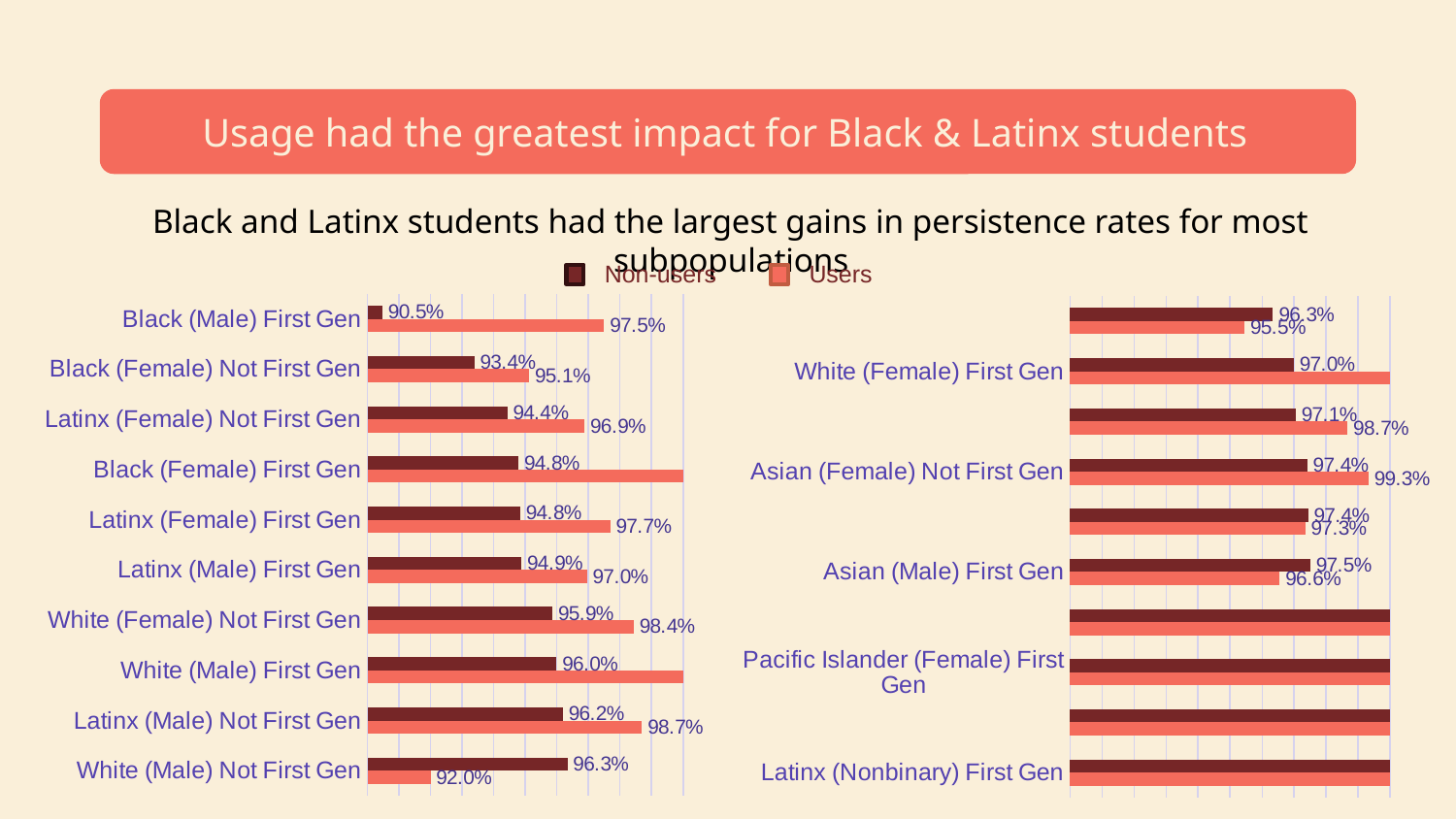
On the left chart, for White (Male) Not First Gen, which is larger: the Non-users rate or the Users rate? Non-users On the left chart, what is the difference between the Users and Non-users rates for Black (Male) First Gen? 7.0 percentage points On the right chart, what is the Users persistence rate for Asian (Female) Not First Gen? 99.3% How many series does the legend list? 2 What type of chart is shown on the left side of the slide? Bar chart On the left chart, which group has the lowest Non-users persistence rate? Black (Male) First Gen On the left chart, what is the Users value for White (Female) Not First Gen? 98.4% On the left chart, what is the persistence rate for Non-users in the Black (Male) First Gen group? 90.5% On the left chart, which group has the lowest Users persistence rate? White (Male) Not First Gen On the left chart, what is the persistence rate for Users in the Latinx (Male) Not First Gen group? 98.7% On the right chart, for Asian (Male) First Gen, which is larger: the Non-users rate or the Users rate? Non-users How many groups are listed on the left chart? 10